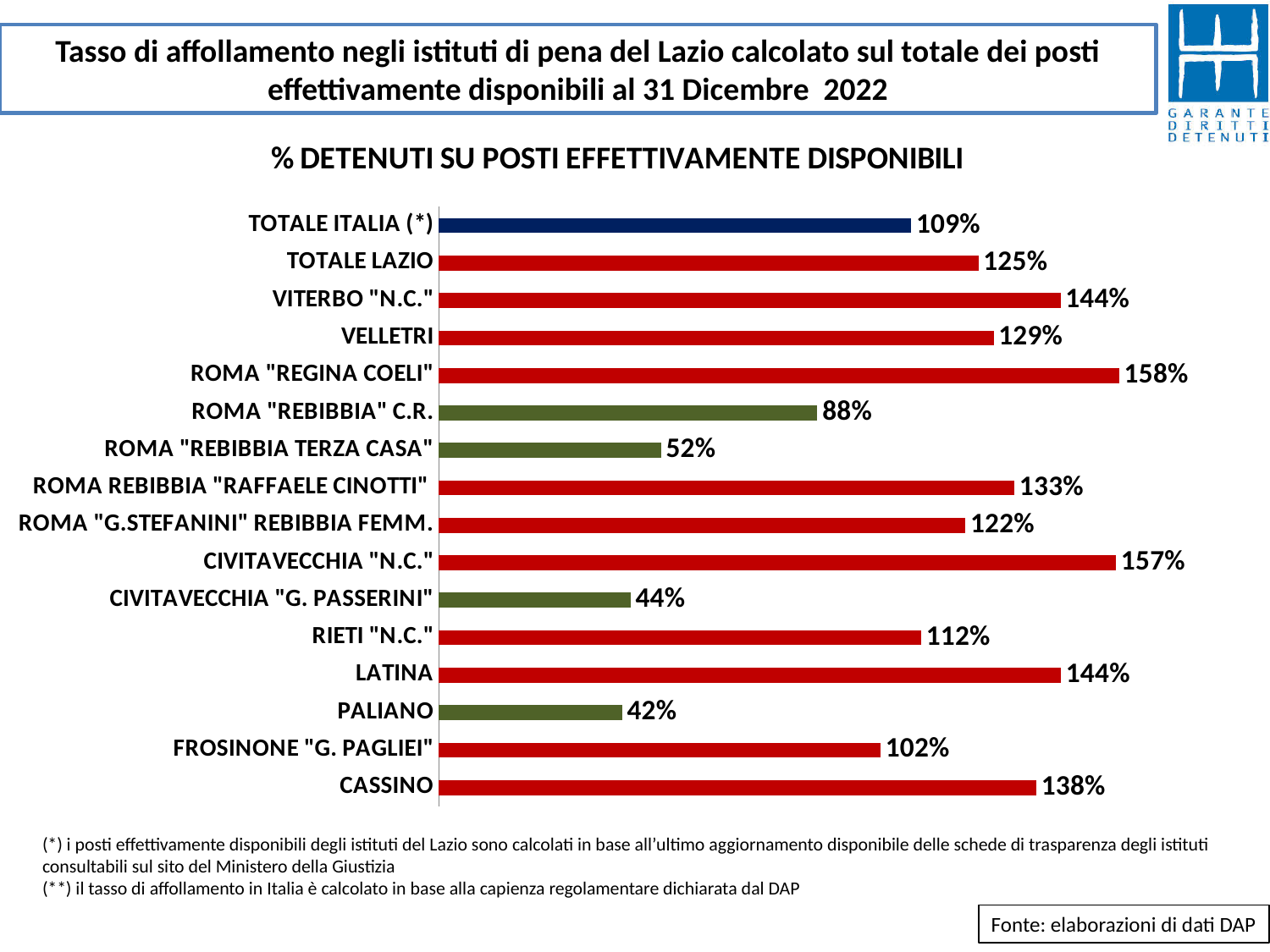
What is the value for ROMA "REGINA COELI"? 158% What is the title shown above the chart? % DETENUTI SU POSTI EFFETTIVAMENTE DISPONIBILI How many categories are shown in the chart? 16 What is the value for ROMA "REBIBBIA TERZA CASA"? 52% What is the value for TOTALE LAZIO? 125% What is the difference between the values for TOTALE LAZIO and TOTALE ITALIA (*)? 16% Which category has the highest value? ROMA "REGINA COELI" Which is larger, the value for VELLETRI or the value for RIETI "N.C."? VELLETRI What kind of chart is shown on the slide? Bar chart What is the difference between the values for CIVITAVECCHIA "N.C." and CIVITAVECCHIA "G. PASSERINI"? 113% Which category has the lowest value? PALIANO What is the value for CASSINO? 138%